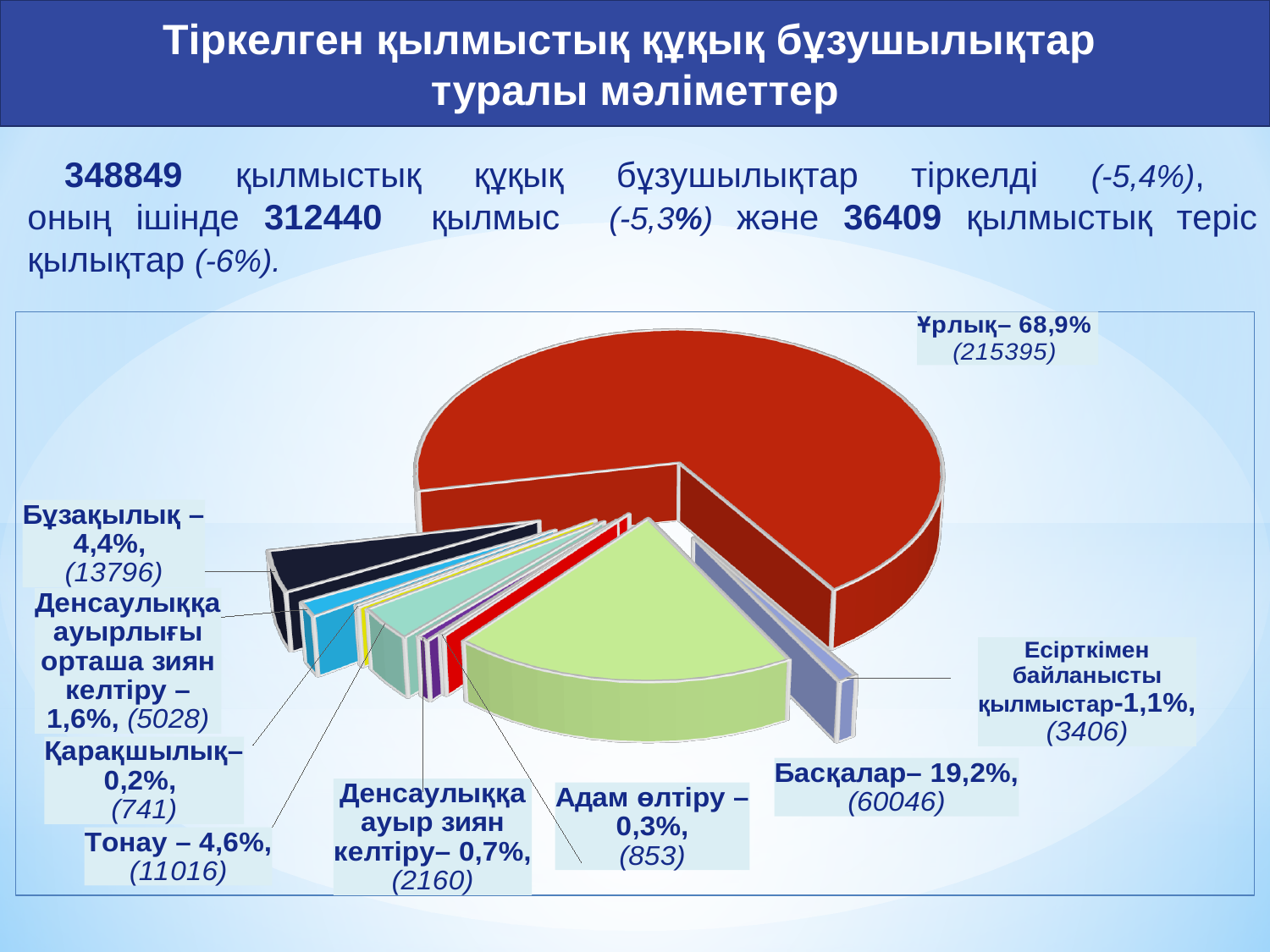
What is the value shown in parentheses for Тонау? 11016 What is the value shown in parentheses for Есірткімен байланысты қылмыстар? 3406 What share of the pie does Ұрлық account for? 68,9% What is the difference between the values for Бұзақылық (13796) and Тонау (11016)? 2780 Which is larger, the share for Тонау or the share for Бұзақылық? Тонау How many categories (slices) are labelled on the pie chart? 9 What share of the pie does Басқалар account for? 19,2% What percentage is shown for Адам өлтіру? 0,3% Which category has the smallest slice of the pie? Қарақшылық What is the value shown in parentheses for Ұрлық? 215395 What kind of chart is shown on the slide? pie chart Which category has the largest slice of the pie? Ұрлық